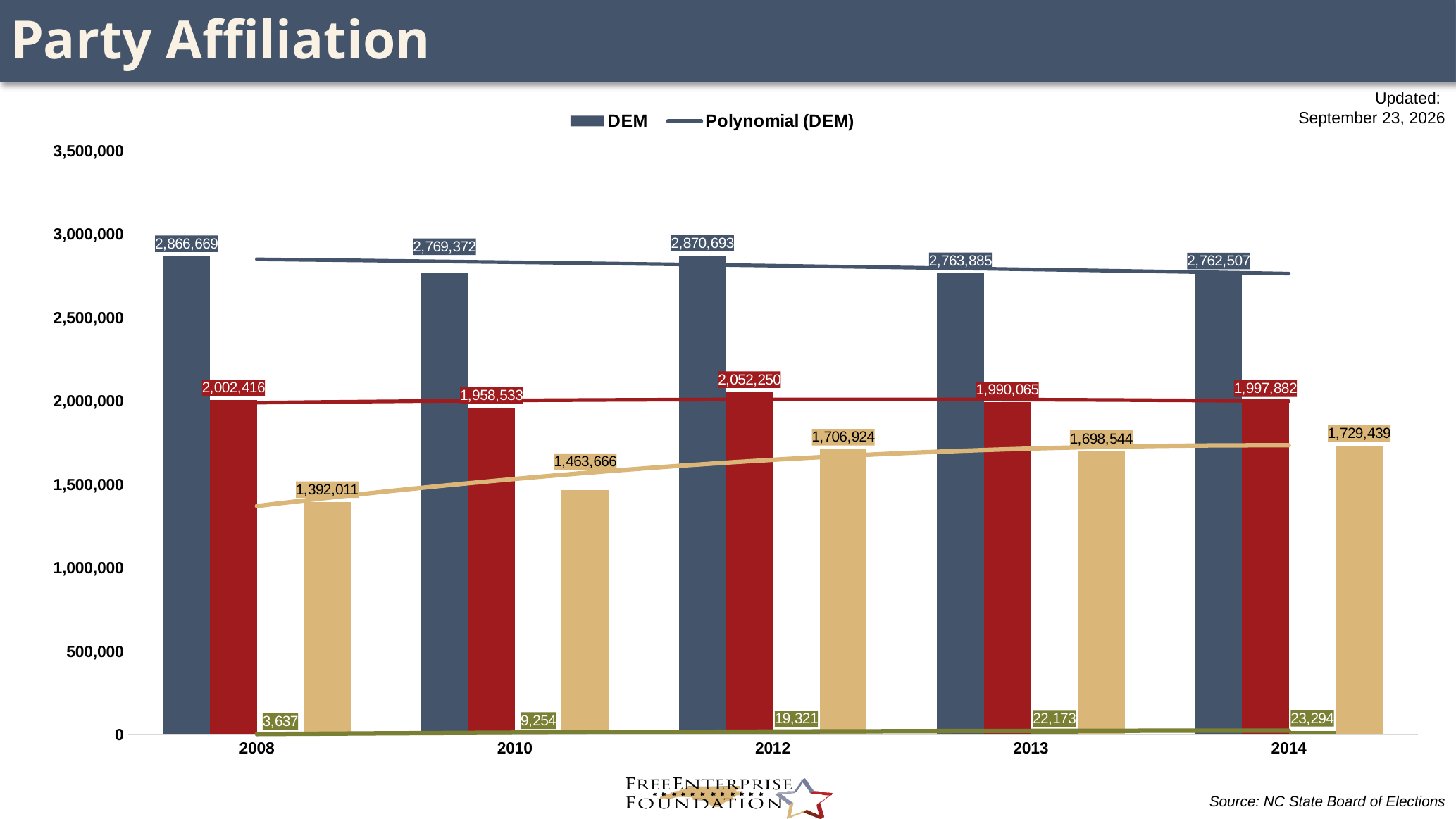
What is the value of the tan bar for 2012? 1,706,924 What is the difference between the DEM values for 2008 and 2010? 97,297 What kind of chart is shown on the slide? bar chart In which year is the DEM value highest? 2012 In which year is the tan bar lowest? 2008 Is the DEM value for 2008 greater or less than 2,500,000? greater What is the DEM value for 2012? 2,870,693 What is the DEM value for 2014? 2,762,507 Which year has the larger red bar, 2010 or 2012? 2012 What is the value of the green bar for 2014? 23,294 How many years are shown on the x axis? 5 How many entries does the legend list? 2